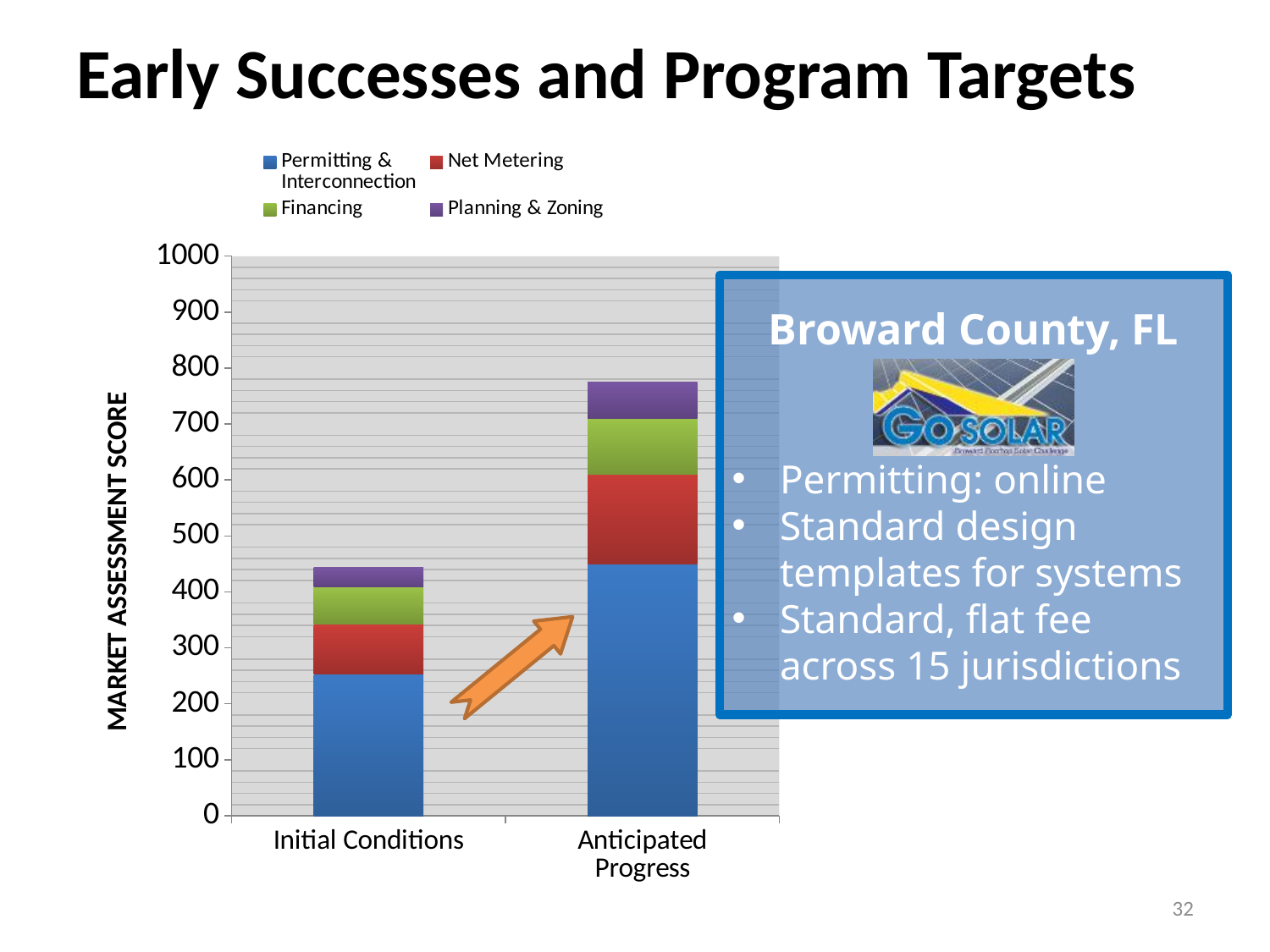
Is the Permitting & Interconnection value for Anticipated Progress greater or less than 400? greater Do the stacked bar totals rise or fall from Initial Conditions to Anticipated Progress? Rise Which category has the taller stacked bar, Initial Conditions or Anticipated Progress? Anticipated Progress Which series forms the largest segment of the Anticipated Progress bar? Permitting & Interconnection How many series does the chart's legend list? 4 What colour represents the Financing series in the chart? Green Is the total stacked bar for Anticipated Progress greater or less than 700? greater What kind of chart is shown on the slide? Stacked bar chart What is the title of the chart's vertical axis? MARKET ASSESSMENT SCORE Is the Permitting & Interconnection value for Initial Conditions greater or less than 300? less How many categories are shown on the x axis of the chart? 2